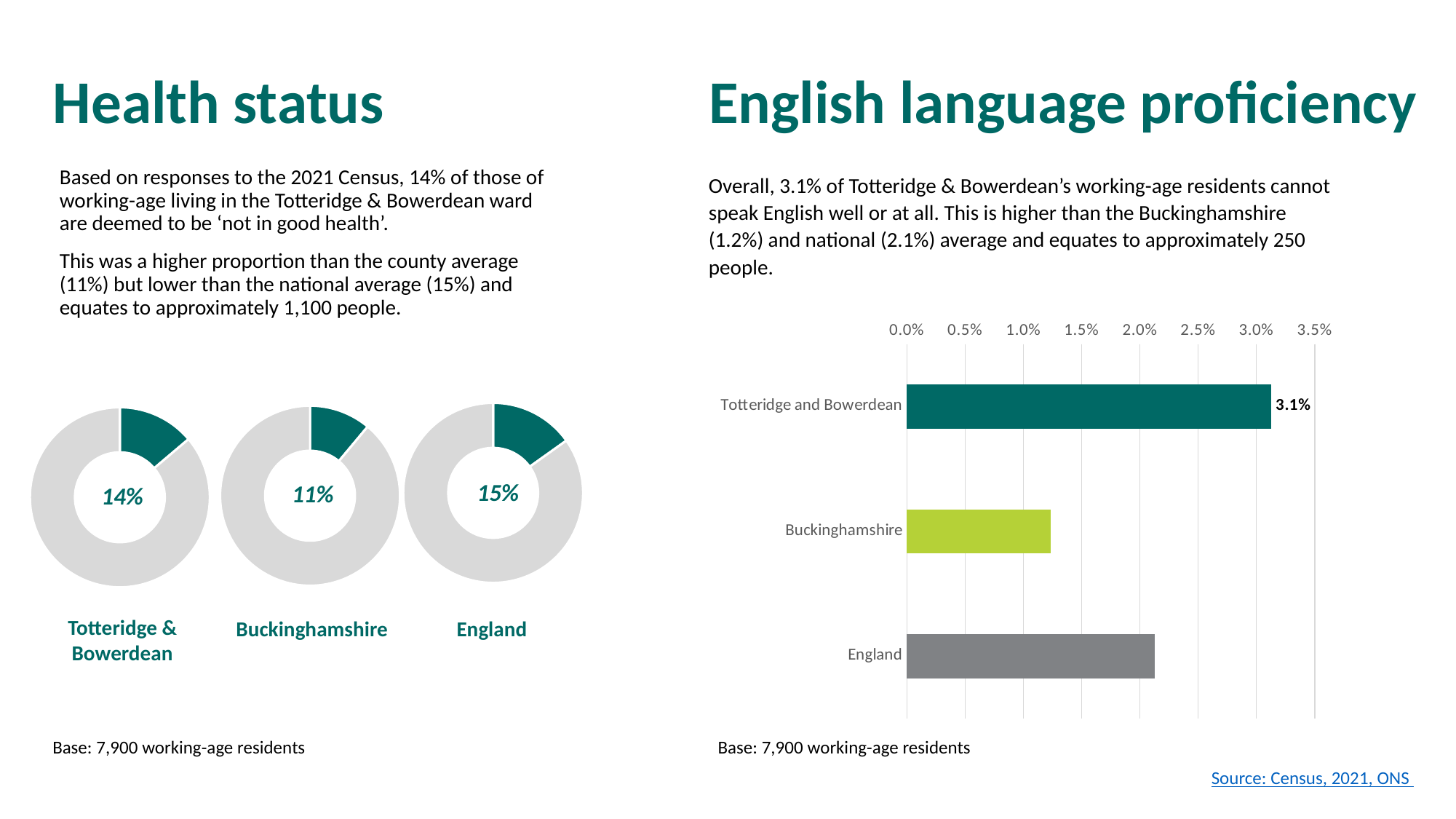
In the Health status donut charts, what percentage is shown for England? 15% In the English language proficiency chart, is the value for England greater or less than 2.0%? greater In the English language proficiency chart, which area has the longest bar? Totteridge and Bowerdean How many donut charts are shown under the Health status heading? 3 In the Health status donut charts, what percentage is shown for Buckinghamshire? 11% What type of chart is used for English language proficiency? Bar chart In the Health status donut charts, which area has the lowest percentage? Buckinghamshire In the English language proficiency chart, is the value for Buckinghamshire greater or less than 1.5%? less In the Health status donut charts, what percentage is shown for Totteridge & Bowerdean? 14% In the English language proficiency chart, what is the value for Totteridge and Bowerdean? 3.1% In the Health status donut charts, which area has the highest percentage? England In the Health status donut charts, what is the difference between the England value and the Buckinghamshire value? 4%